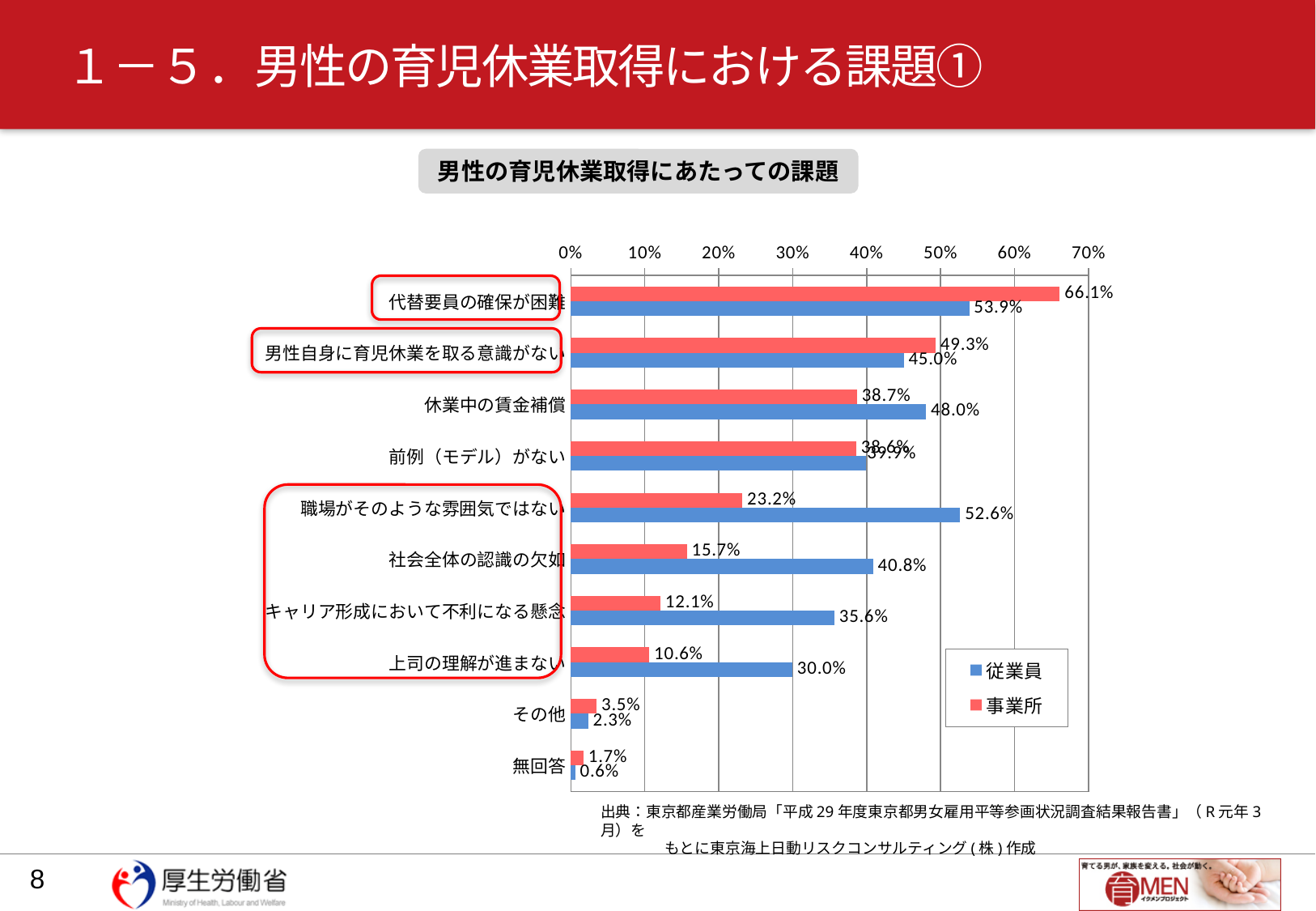
For 休業中の賃金補償, which is larger, the 従業員 value or the 事業所 value? 従業員 What is the 事業所 value for 代替要員の確保が困難? 66.1% What is the difference between the 従業員 and 事業所 values for 社会全体の認識の欠如? 25.1% Which category has the lowest 従業員 value? 無回答 How many series does the legend list? 2 How many categories are plotted in the chart? 10 What type of chart is shown on the slide? Bar chart What is the 従業員 value for 上司の理解が進まない? 30.0% Is the 従業員 value for キャリア形成において不利になる懸念 greater or less than 30%? greater Which category has the highest 事業所 value? 代替要員の確保が困難 What is the 従業員 value for 職場がそのような雰囲気ではない? 52.6% Which colour represents the 事業所 series in the chart? Red